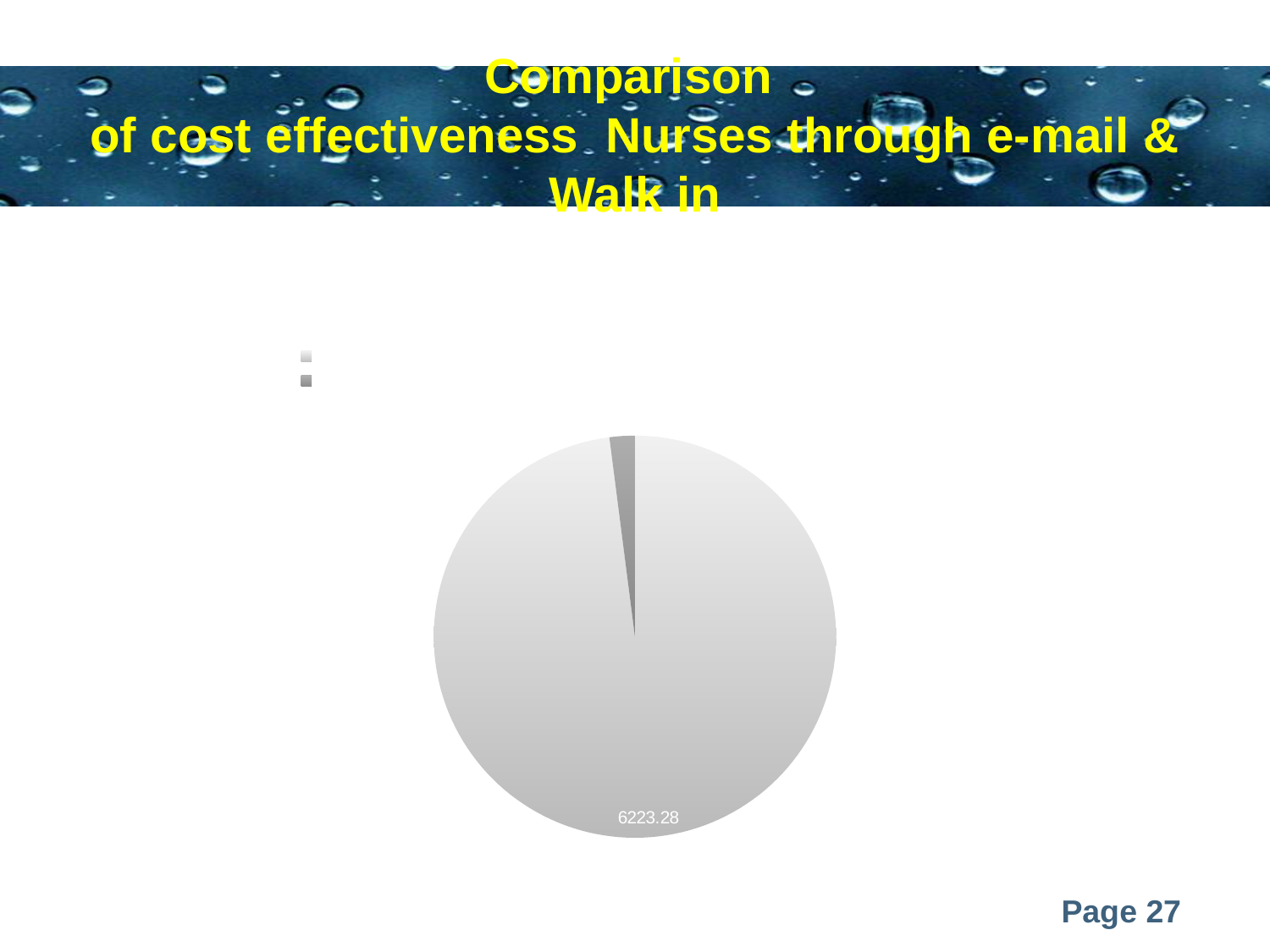
Which slice of the pie chart is larger, the light grey slice or the dark grey slice? the light grey slice How many slices does the pie chart have? 2 Does the light grey slice take up more or less than half of the pie chart? more Which slice of the pie chart is the smallest? the dark grey slice What kind of chart is shown on the slide? pie chart How many entries does the legend of the pie chart list? 2 What is the title of the slide containing the pie chart? Comparison of cost effectiveness Nurses through e-mail & Walk in How many data labels are printed on the pie chart? 1 What value is printed on the large light grey slice of the pie chart? 6223.28